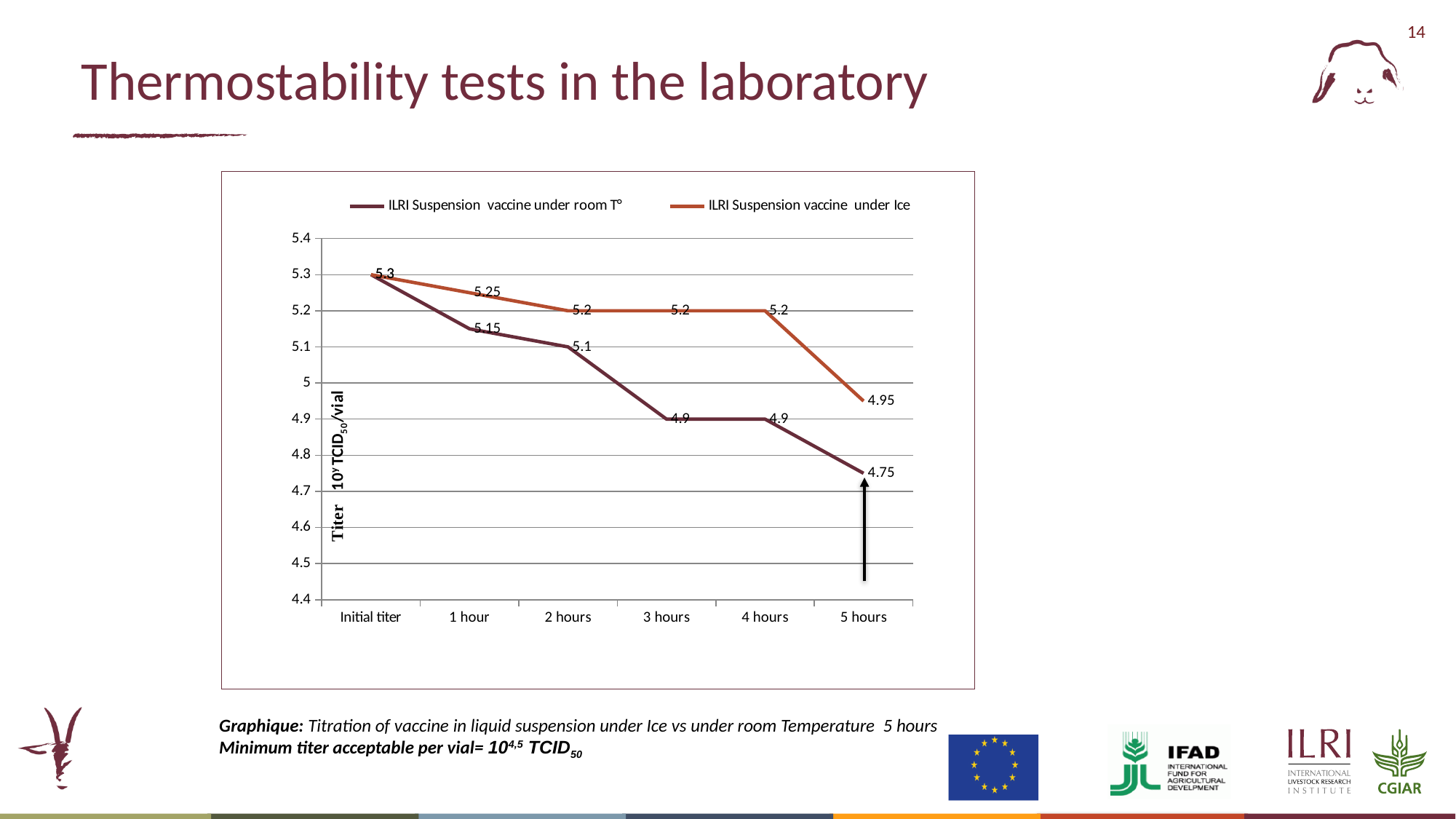
Do the titer values for the vaccine under room T° rise or fall from the initial titer to 5 hours? Fall What is the difference between the two series at 5 hours? 0.2 How many time points are plotted on the x axis? 6 What is the titer for the ILRI Suspension vaccine under Ice at 1 hour? 5.25 What is the titer for the ILRI Suspension vaccine under room T° at 2 hours? 5.1 What is the difference between the initial titer and the room T° titer at 5 hours? 0.55 What kind of chart is shown on the slide? Line chart What is the titer for the ILRI Suspension vaccine under Ice at 5 hours? 4.95 What is the titer for the ILRI Suspension vaccine under room T° at 5 hours? 4.75 What is the initial titer shared by both series? 5.3 How many series does the legend list? 2 At 3 hours, which series has the higher titer: under room T° or under Ice? ILRI Suspension vaccine under Ice